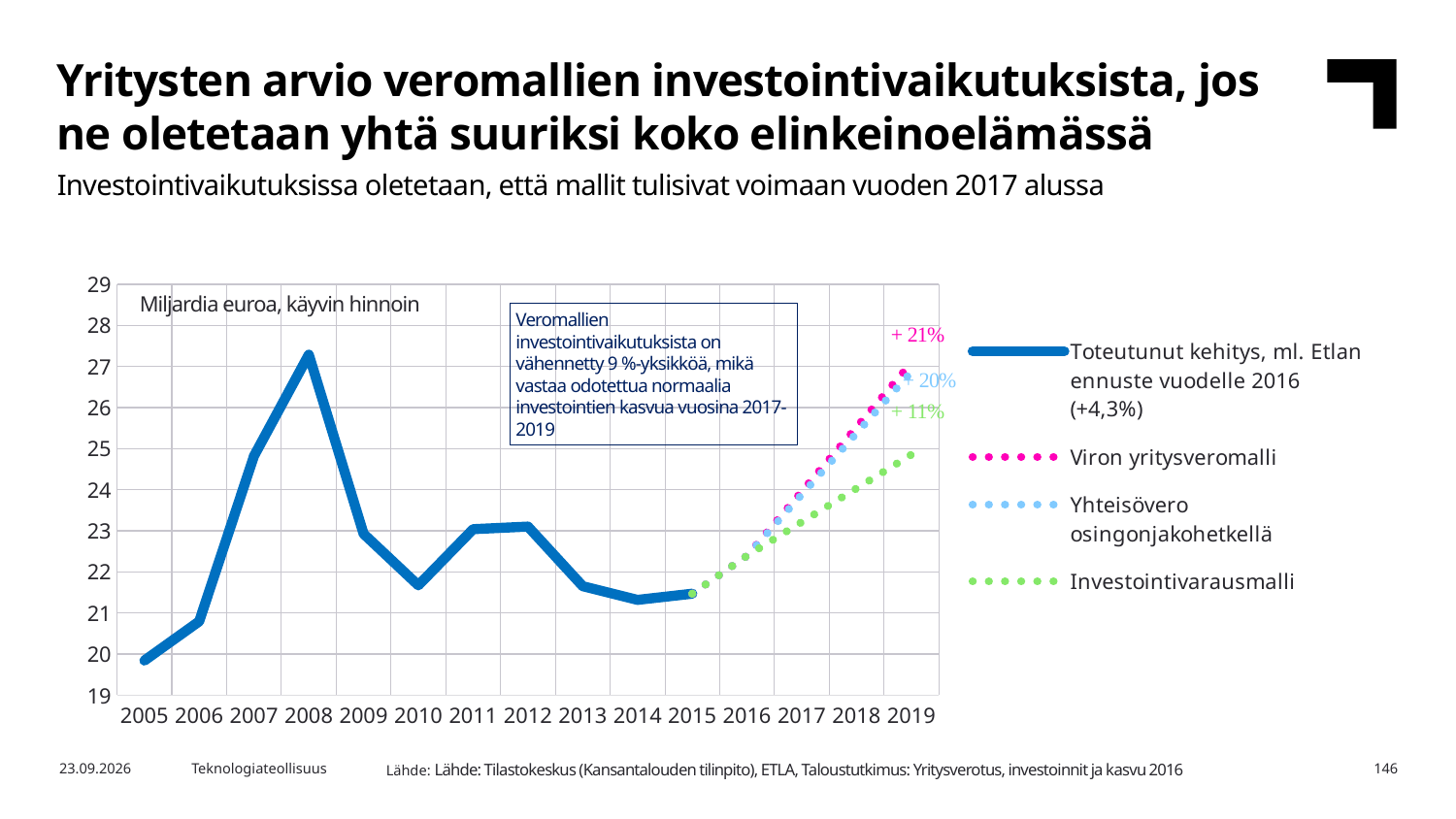
How many series does the legend list? 4 Is the value of the solid line in 2014 greater or less than 22? less Is the value of the solid line in 2005 greater or less than 20? less How many years are shown on the x axis? 15 What unit label is shown inside the chart area? Miljardia euroa, käyvin hinnoin What kind of chart is shown on the slide? line chart Which projected series ends highest in 2019? Viron yritysveromalli In which year does the solid line (Toteutunut kehitys) have its lowest value? 2005 Is the value of the solid line in 2008 greater or less than 27? greater What percentage increase is labelled for the Investointivarausmalli projection in 2019? +11% In which year does the solid line (Toteutunut kehitys) reach its highest value? 2008 Which is larger, the solid line's value in 2008 or in 2012? 2008